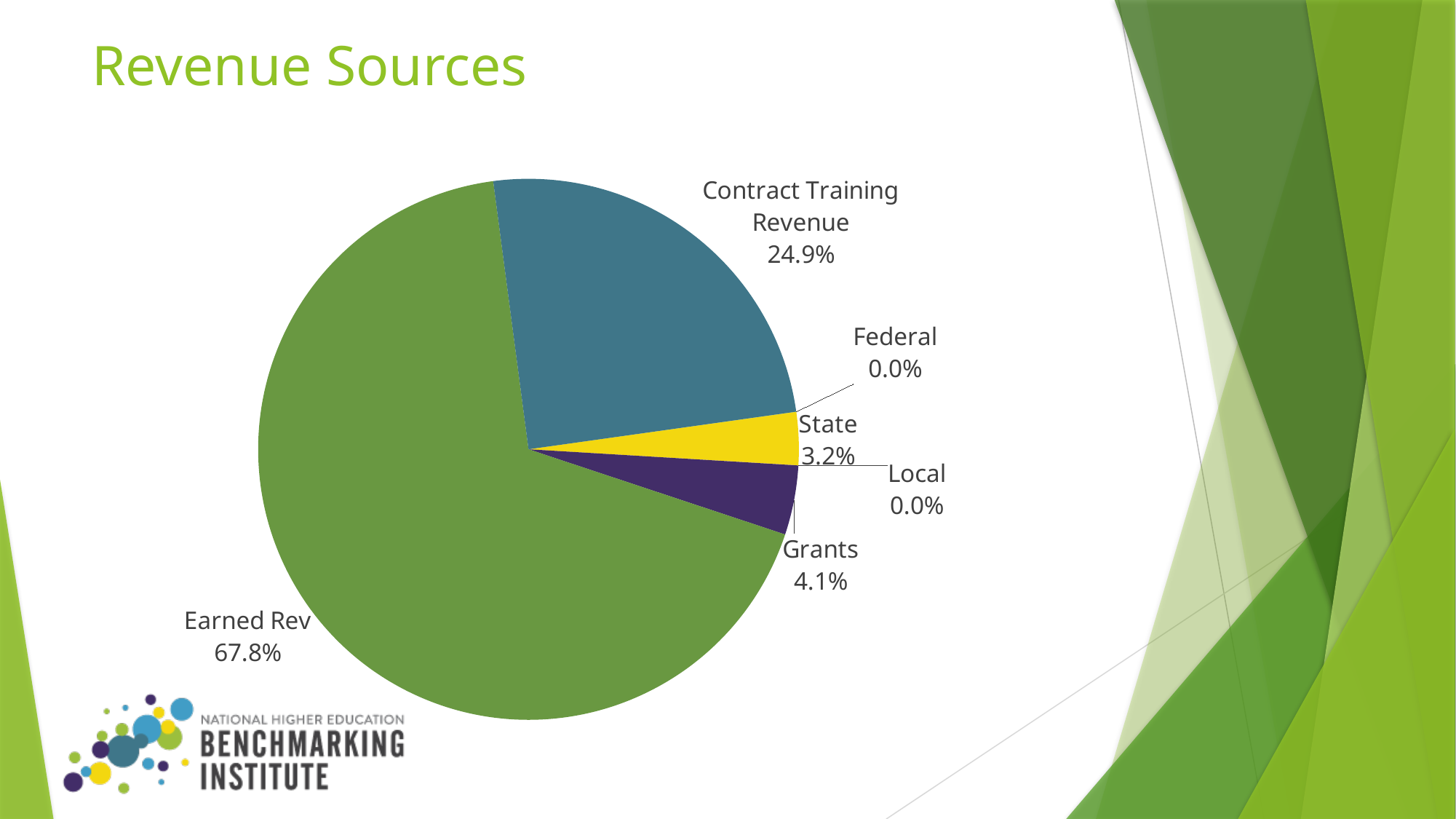
What share of revenue comes from Federal? 0.0% What share of revenue comes from Earned Rev? 67.8% What kind of chart is shown on the slide? Pie chart What is the difference between the Earned Rev share and the Contract Training Revenue share? 42.9% What share of revenue comes from Contract Training Revenue? 24.9% Which revenue source has the largest share? Earned Rev Which is larger, the share for Grants or the share for State? Grants What share of revenue comes from Grants? 4.1% What is the title of the slide containing the chart? Revenue Sources What is the difference between the Grants share and the State share? 0.9% What share of revenue comes from State? 3.2% How many revenue source categories are labelled on the pie chart? 6